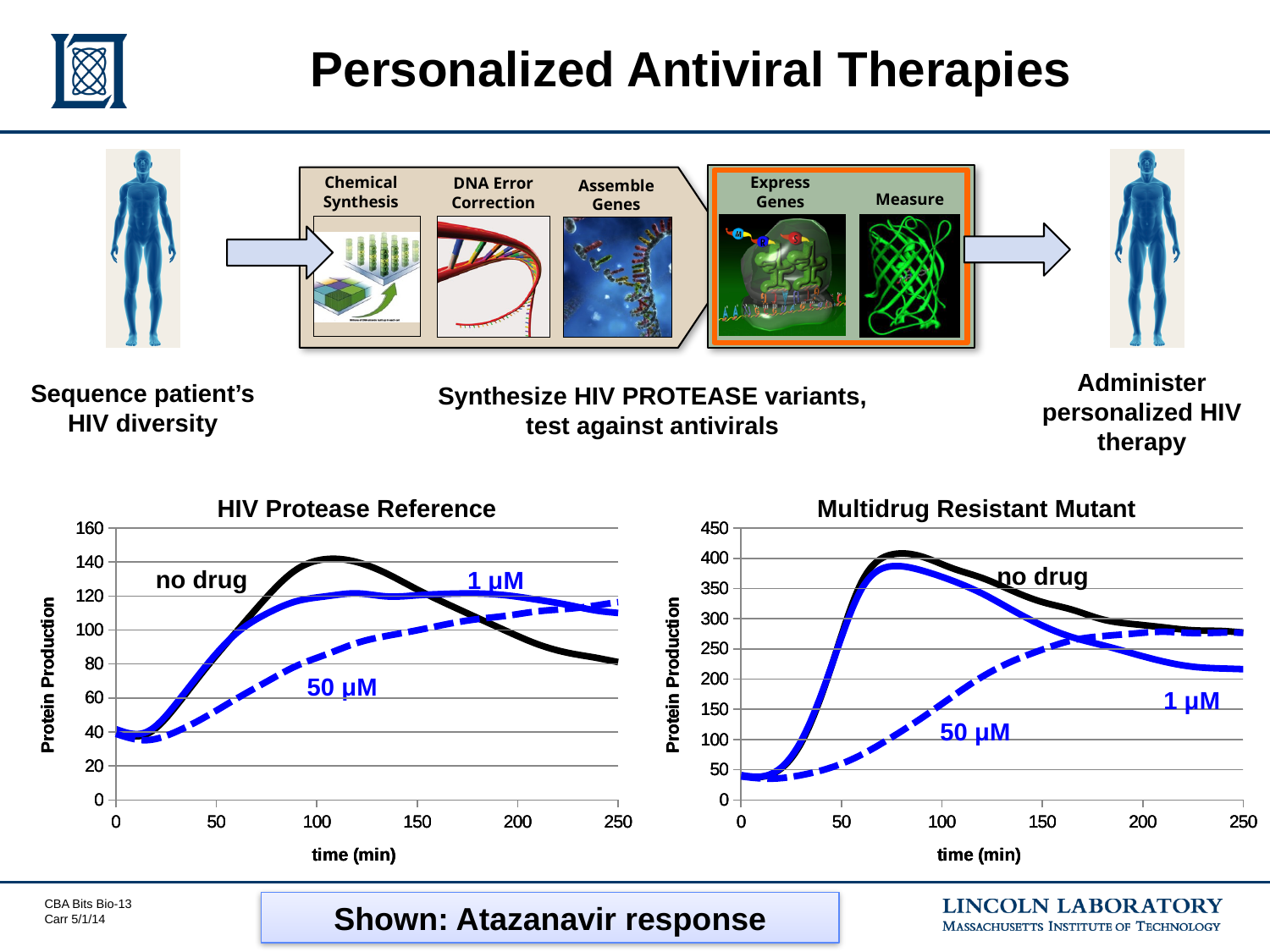
On the HIV Protease Reference chart, at 100 min, which curve is higher: no drug or 50 µM? no drug On the Multidrug Resistant Mutant chart, at 250 min, which curve is higher: 1 µM or 50 µM? 50 µM On the HIV Protease Reference chart, is the peak value of the no drug curve greater or less than 120? greater On the Multidrug Resistant Mutant chart, is the peak value of the no drug curve greater or less than 350? greater What kind of chart is the HIV Protease Reference chart? line chart How many drug conditions are labeled on the Multidrug Resistant Mutant chart? 3 On the HIV Protease Reference chart, does the 50 µM curve generally rise or fall as time increases? rise What is the y-axis label on the Multidrug Resistant Mutant chart? Protein Production On the HIV Protease Reference chart, which curve reaches the highest peak? no drug On the Multidrug Resistant Mutant chart, is the 50 µM curve at 50 min greater or less than 100? less On the HIV Protease Reference chart, does the no drug curve rise or fall between 100 min and 250 min? fall What is the x-axis label on the HIV Protease Reference chart? time (min)